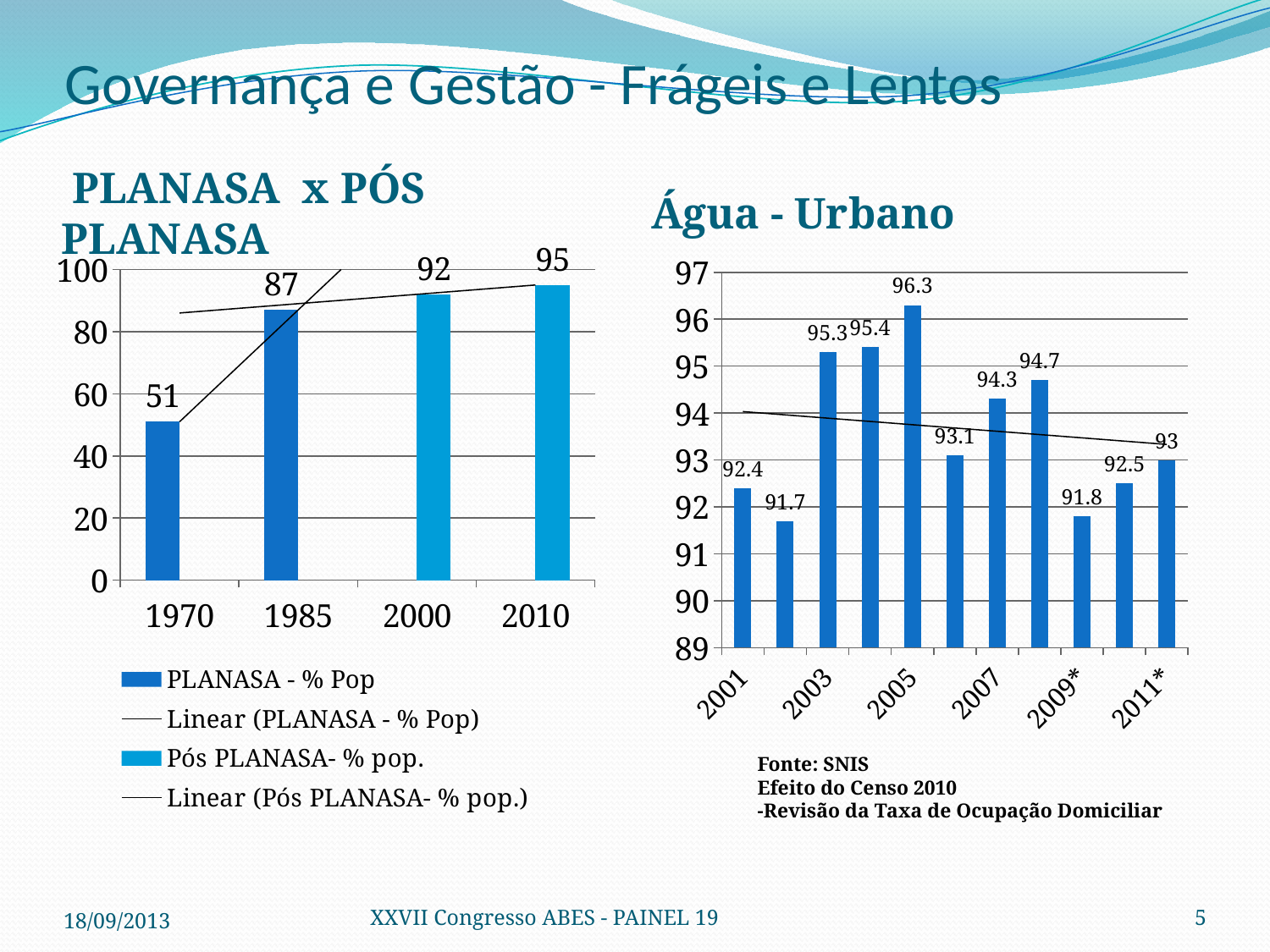
In the Água - Urbano chart, what is the value for 2009*? 91.8 In the PLANASA x PÓS PLANASA chart, how many entries does the legend list? 4 In the PLANASA x PÓS PLANASA chart, what is the difference between the values for 1985 and 1970? 36 In the PLANASA x PÓS PLANASA chart, what is the value for 2010? 95 In the PLANASA x PÓS PLANASA chart, what is the value for 1970? 51 In the Água - Urbano chart, which year has the highest value? 2005 In the Água - Urbano chart, how many bars are plotted? 11 In the Água - Urbano chart, what is the value for 2005? 96.3 In the PLANASA x PÓS PLANASA chart, which year has the lowest value? 1970 In the PLANASA x PÓS PLANASA chart, do the bar values rise or fall from 1970 to 2010? rise What kind of chart is the Água - Urbano chart? bar chart In the Água - Urbano chart, which is larger, the value for 2003 or the value for 2007? 2003